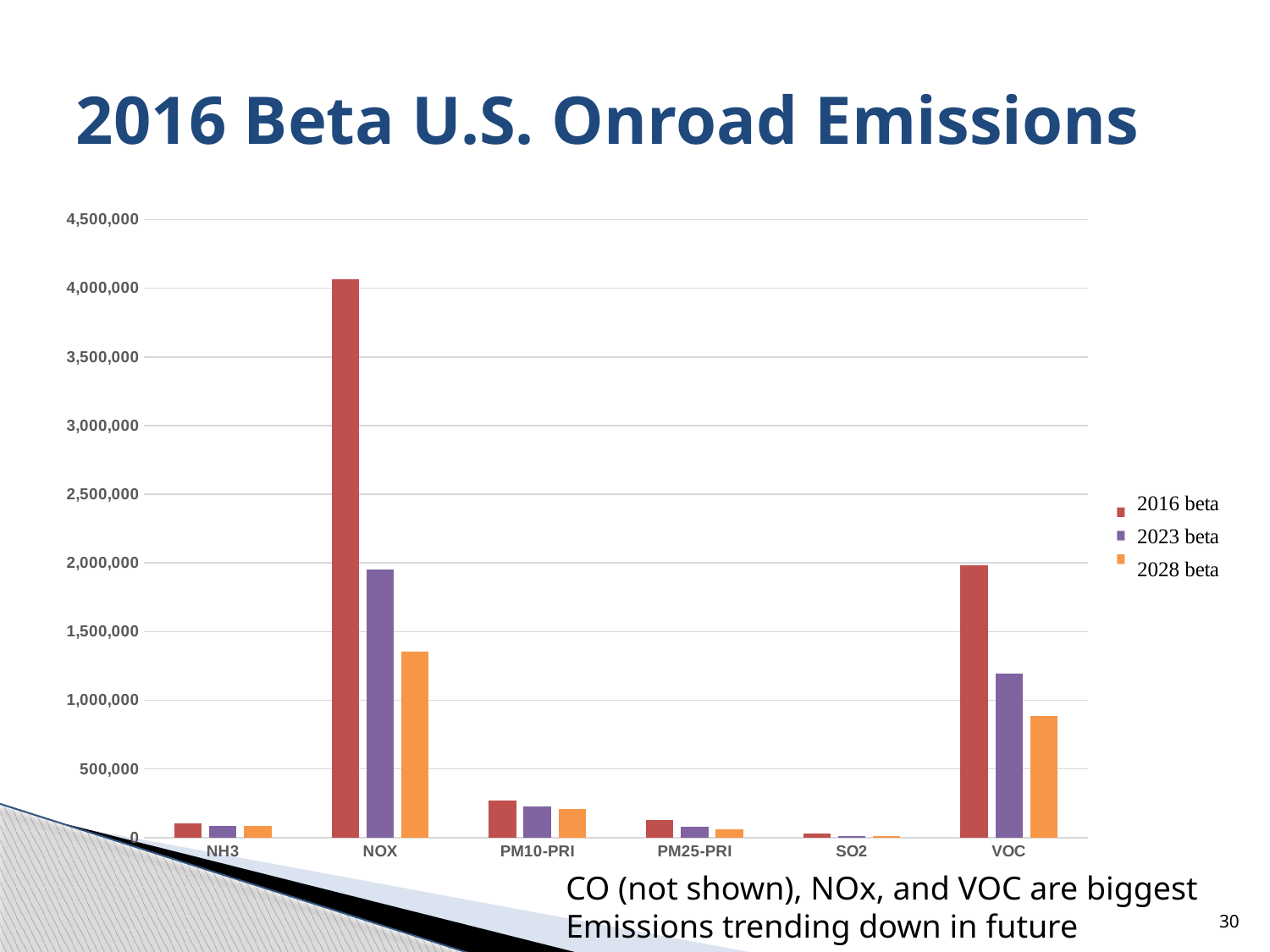
What kind of chart is shown on the slide? bar chart How many series does the legend list? 3 Is the 2016 beta value for PM10-PRI greater or less than 500,000? less What is the title of the chart? 2016 Beta U.S. Onroad Emissions Is the 2016 beta value for NOX greater or less than 3,500,000? greater Is the 2028 beta value for VOC greater or less than 1,000,000? less Within each category, do the values rise or fall from 2016 beta to 2028 beta? fall Which category has the highest 2016 beta value? NOX Which category has the lowest 2016 beta value? SO2 How many pollutant categories are shown on the x axis? 6 Which is larger for 2016 beta, NOX or VOC? NOX